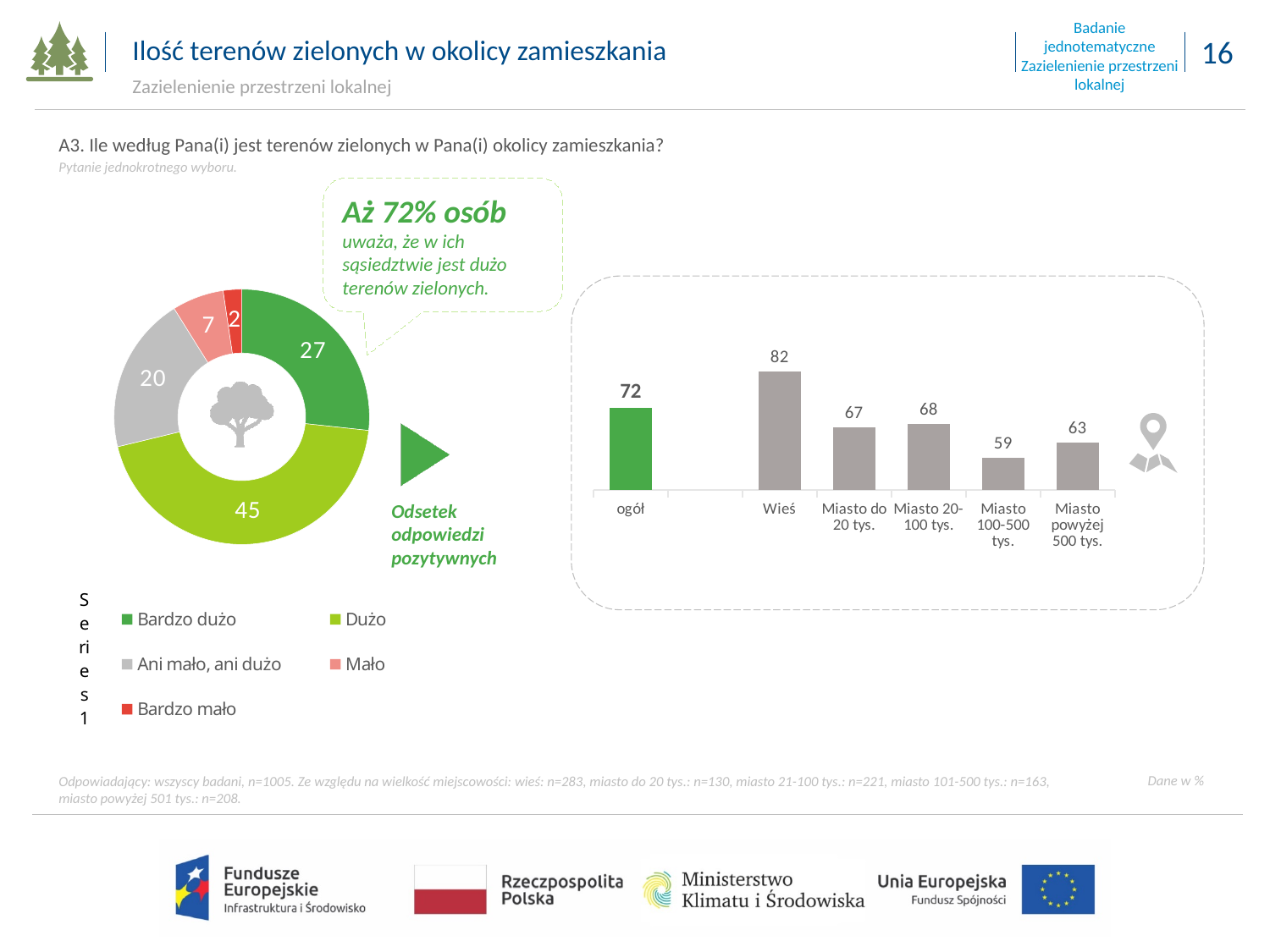
In the bar chart on the right, what is the difference between the values for "Wieś" and "ogół"? 10 In the bar chart on the right, which category has the lowest value? Miasto 100-500 tys. In the bar chart on the right, which category has the highest value? Wieś What type of chart is shown on the right side of the slide? Bar chart In the doughnut chart on the left, what is the value for "Dużo"? 45 In the doughnut chart on the left, what is the difference between the values for "Ani mało, ani dużo" and "Mało"? 13 In the doughnut chart on the left, what is the value for "Bardzo dużo"? 27 In the doughnut chart on the left, how many categories does the legend list? 5 In the bar chart on the right, what is the value for "Wieś"? 82 In the bar chart on the right, what is the value for "Miasto 100-500 tys."? 59 In the doughnut chart on the left, which category has the smallest value? Bardzo mało In the doughnut chart on the left, which category has the largest value? Dużo